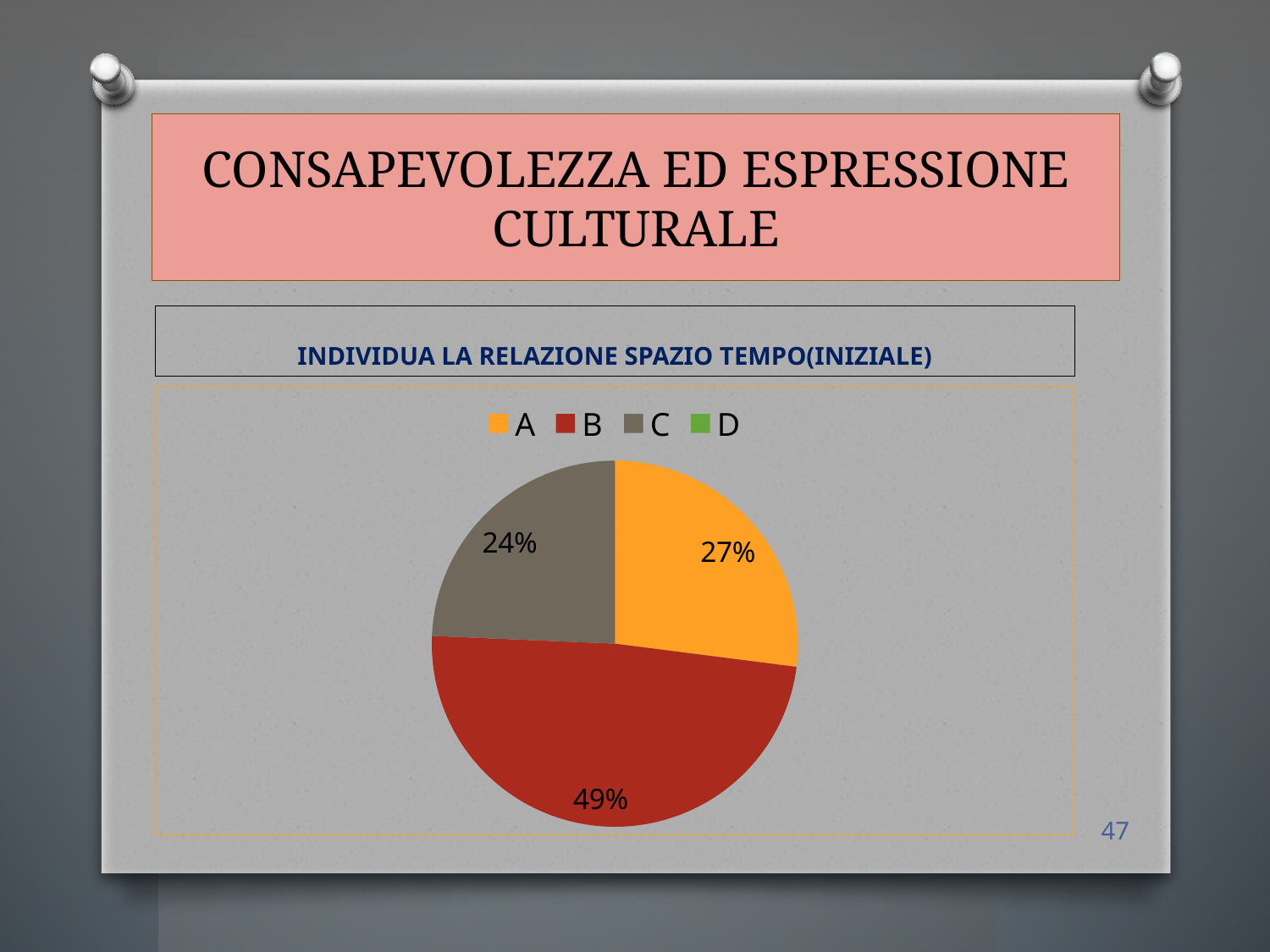
Which category has the largest slice in the pie chart? B Among the slices with printed labels, which category has the smallest share? C What is the difference in percentage points between slice A and slice C? 3% Which is larger, slice A or slice C? A What type of chart is shown on the slide? Pie chart What colour is the slice for category B? Red What percentage does slice C represent in the pie chart? 24% How many categories does the legend list? 4 How many slices with percentage labels are visible in the pie chart? 3 What percentage does slice B represent in the pie chart? 49% What percentage does slice A represent in the pie chart? 27% What is the difference in percentage points between slice B and slice A? 22%